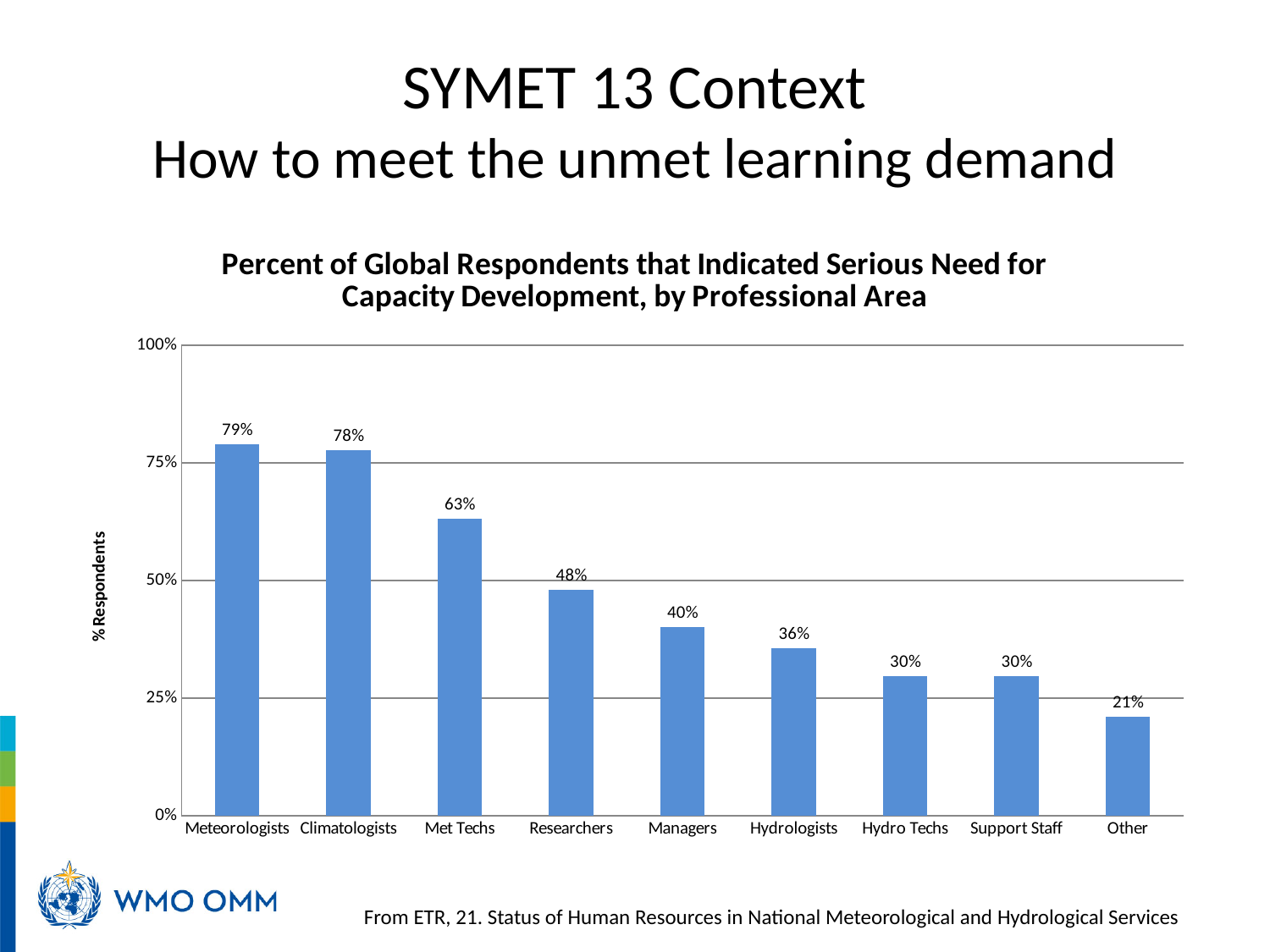
Which professional area has the lowest percentage? Other What is the difference in percentage points between Managers and Hydro Techs? 10 Do the values generally rise or fall from left to right along the x axis? Fall How many professional areas are shown on the x axis? 9 What is the difference in percentage points between Meteorologists and Researchers? 31 Which is larger, the value for Met Techs or the value for Managers? Met Techs Which professional area has the highest percentage of respondents indicating serious need? Meteorologists What percentage of respondents indicated serious need for capacity development among Met Techs? 63% Is the value for Researchers greater or less than 50%? less What is the value shown for Hydrologists? 36% What is the value shown for Other? 21% What kind of chart is shown on the slide? Bar chart